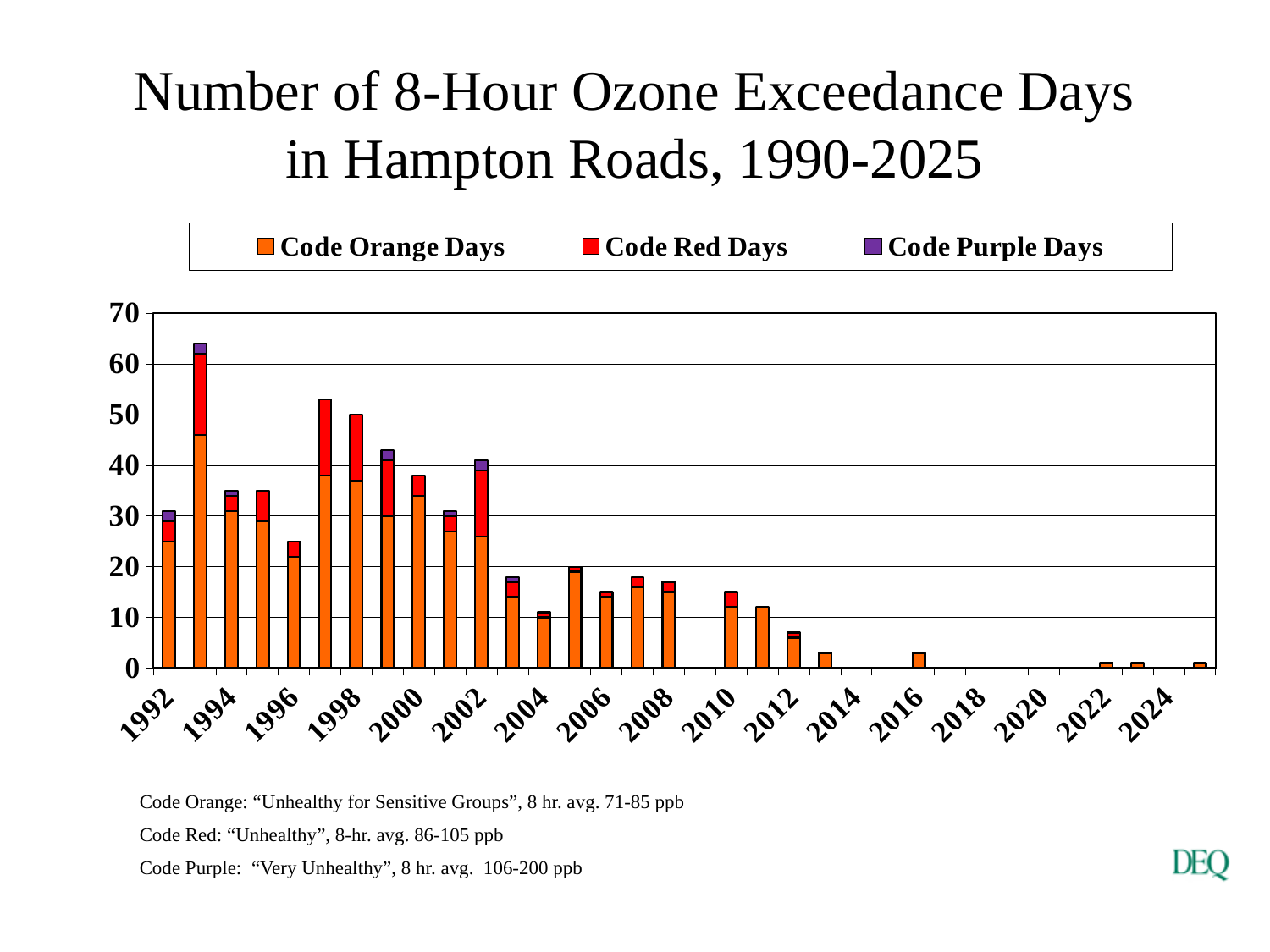
Is the total value for 2004 greater or less than 20? less Is the total value for 1993 greater or less than 60? greater How many series does the legend list? 3 Which year has the larger total, 1993 or 1997? 1993 Overall, do the total exceedance days rise or fall from 1992 to 2024? fall Is the total value for 1996 greater or less than 30? less Which year has the highest total number of exceedance days? 1993 What kind of chart is shown on the slide? Stacked bar chart Which series is shown in orange in the legend? Code Orange Days What is the title of the chart? Number of 8-Hour Ozone Exceedance Days in Hampton Roads, 1990-2025